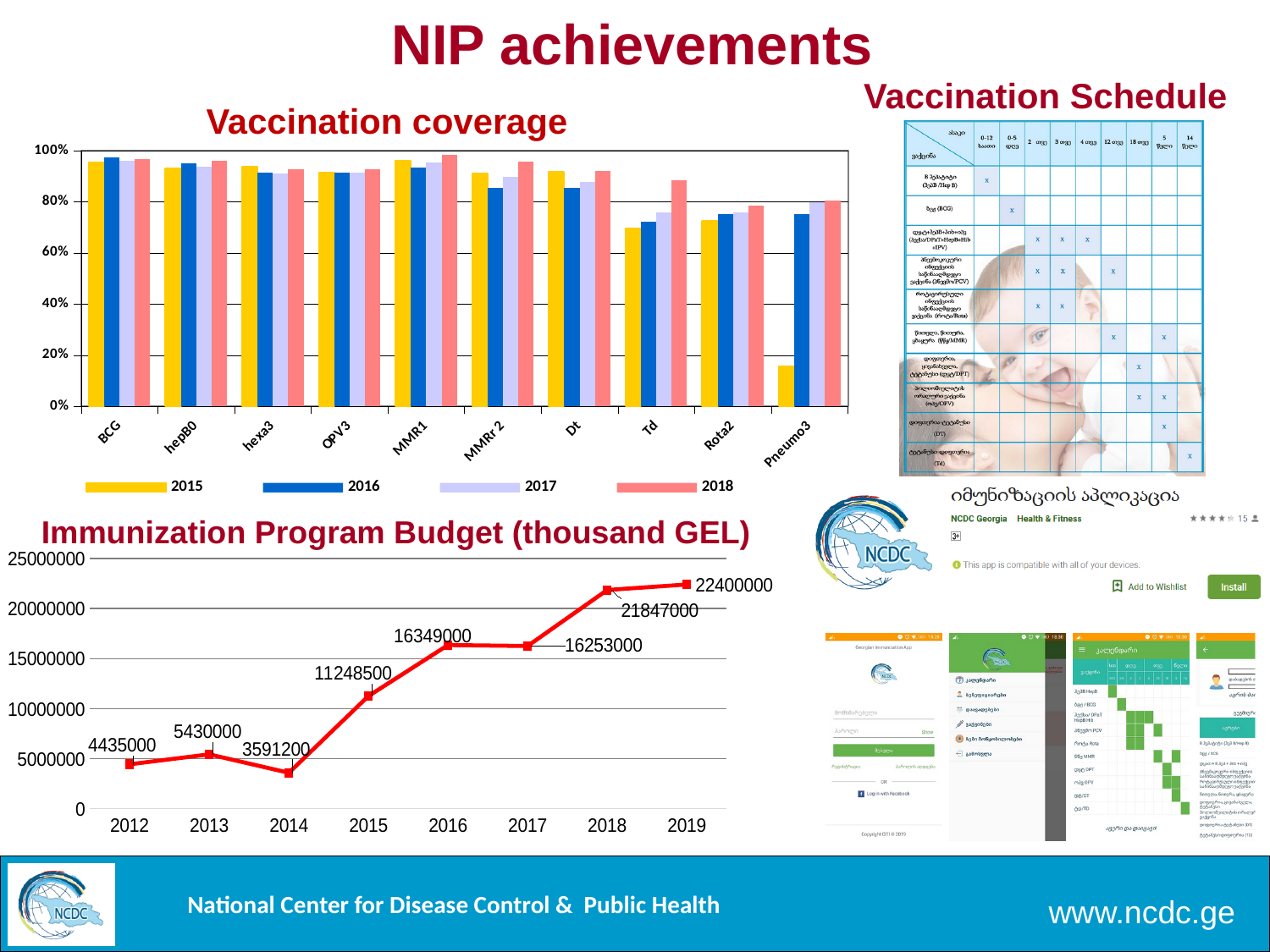
On the Immunization Program Budget chart, which is larger, the value for 2016 or the value for 2017? 2016 On the Immunization Program Budget chart, what is the difference between the 2018 and 2017 values? 5594000 On the Immunization Program Budget chart, what is the value for 2014? 3591200 On the Immunization Program Budget chart, which year has the highest value? 2019 On the Vaccination coverage chart, how many vaccine categories are shown on the x axis? 10 On the Immunization Program Budget chart, which year has the lowest value? 2014 On the Immunization Program Budget chart, what is the value for 2019? 22400000 On the Immunization Program Budget chart, how many years are plotted? 8 What kind of chart is the Immunization Program Budget chart? line chart On the Vaccination coverage chart, is the 2015 value for Pneumo3 greater or less than 20%? less On the Vaccination coverage chart, how many series does the legend list? 4 On the Vaccination coverage chart, is the 2018 value for Td greater or less than 80%? greater